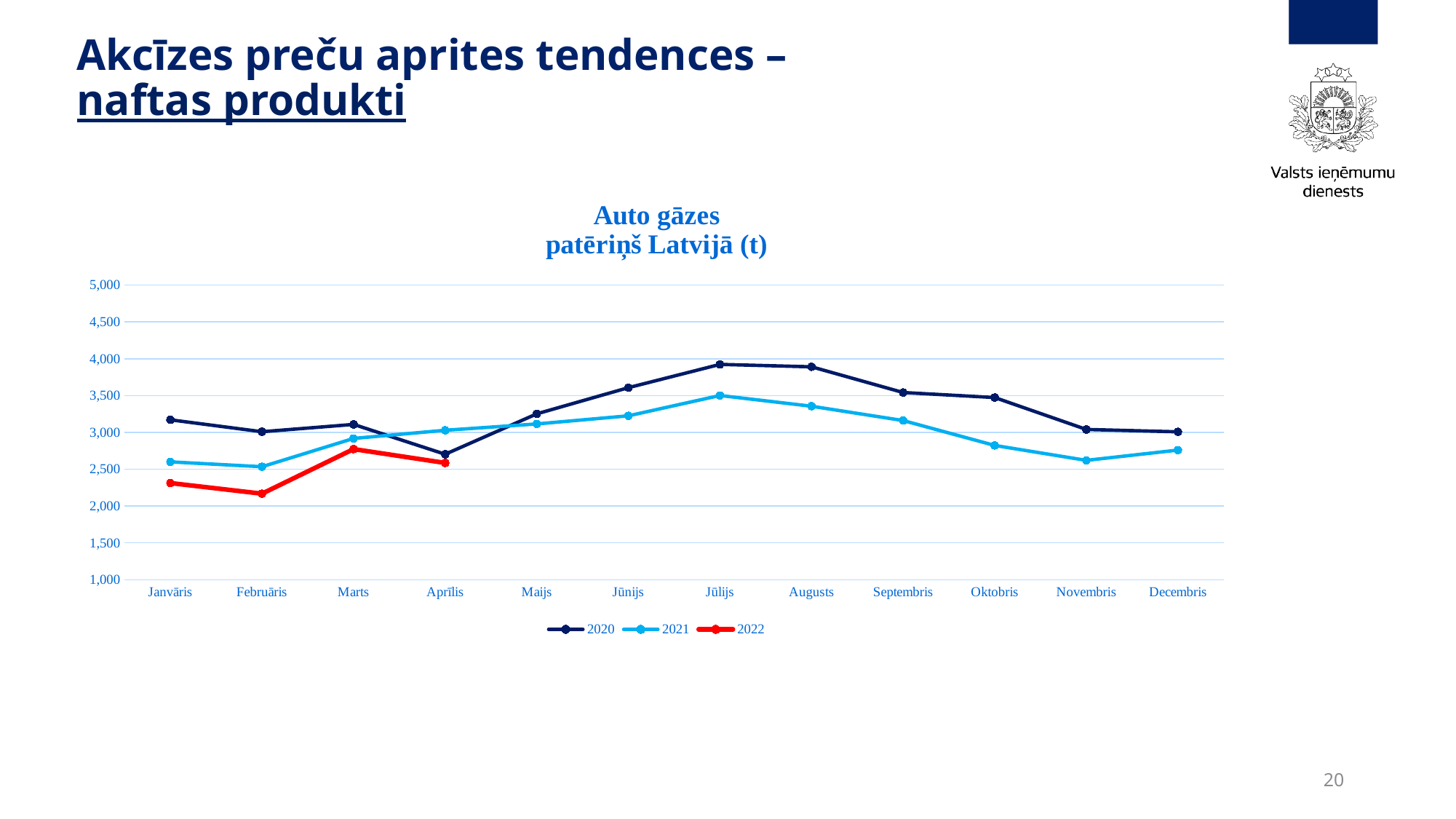
In Aprīlis, which series has the larger value, 2020 or 2021? 2021 How many months are shown along the x axis? 12 Is the value for 2022 in Februāris greater or less than 2,500? less What kind of chart is shown on the slide? line chart Is the value for 2020 in Jūlijs greater or less than 3,500? greater What is the title of the chart? Auto gāzes patēriņš Latvijā (t) How many series does the legend list? 3 In Janvāris, which series has the larger value, 2020 or 2021? 2020 In which month does the 2022 series reach its lowest value? Februāris Is the value for 2020 in Aprīlis greater or less than 3,000? less In which month does the 2021 series reach its highest value? Jūlijs In which month does the 2022 series reach its highest value? Marts